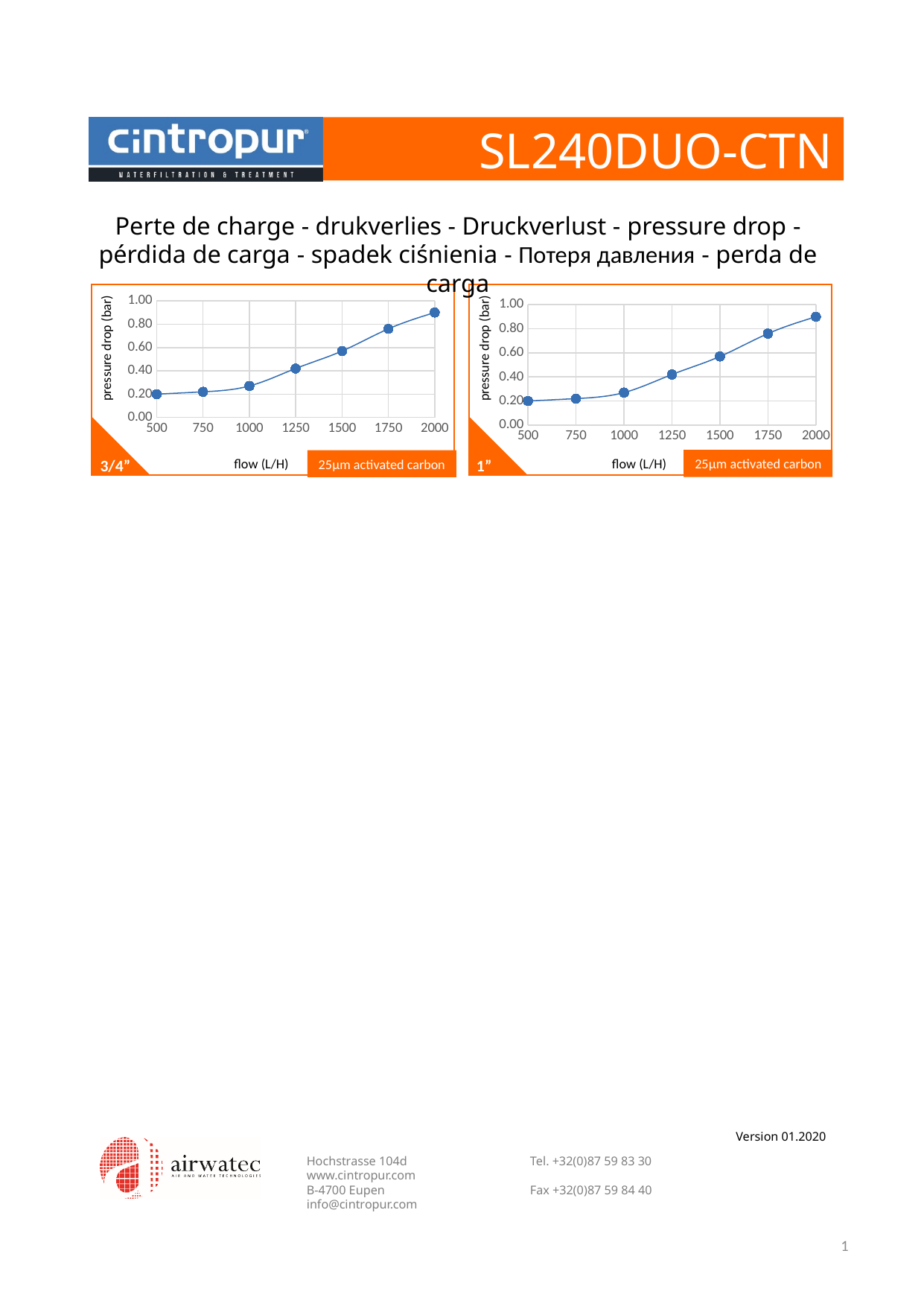
On the left chart (3/4"), what is the label of the y axis? pressure drop (bar) On the left chart (3/4"), is the pressure drop at a flow of 1500 greater or less than 0.40? greater On the left chart (3/4"), is the pressure drop at a flow of 2000 greater or less than 0.80? greater On the right chart (1"), what filter type is named in the orange label below the chart? 25µm activated carbon On the right chart (1"), do the pressure drop values rise or fall as flow increases? rise On the right chart (1"), is the pressure drop at a flow of 1000 greater or less than 0.40? less On the left chart (3/4"), at which flow value is the pressure drop highest? 2000 On the left chart (3/4"), how many data points are plotted? 7 On the right chart (1"), which has the larger pressure drop: a flow of 1000 or a flow of 1500? 1500 On the left chart (3/4"), what kind of chart is shown? line chart On the right chart (1"), at which flow value is the pressure drop lowest? 500